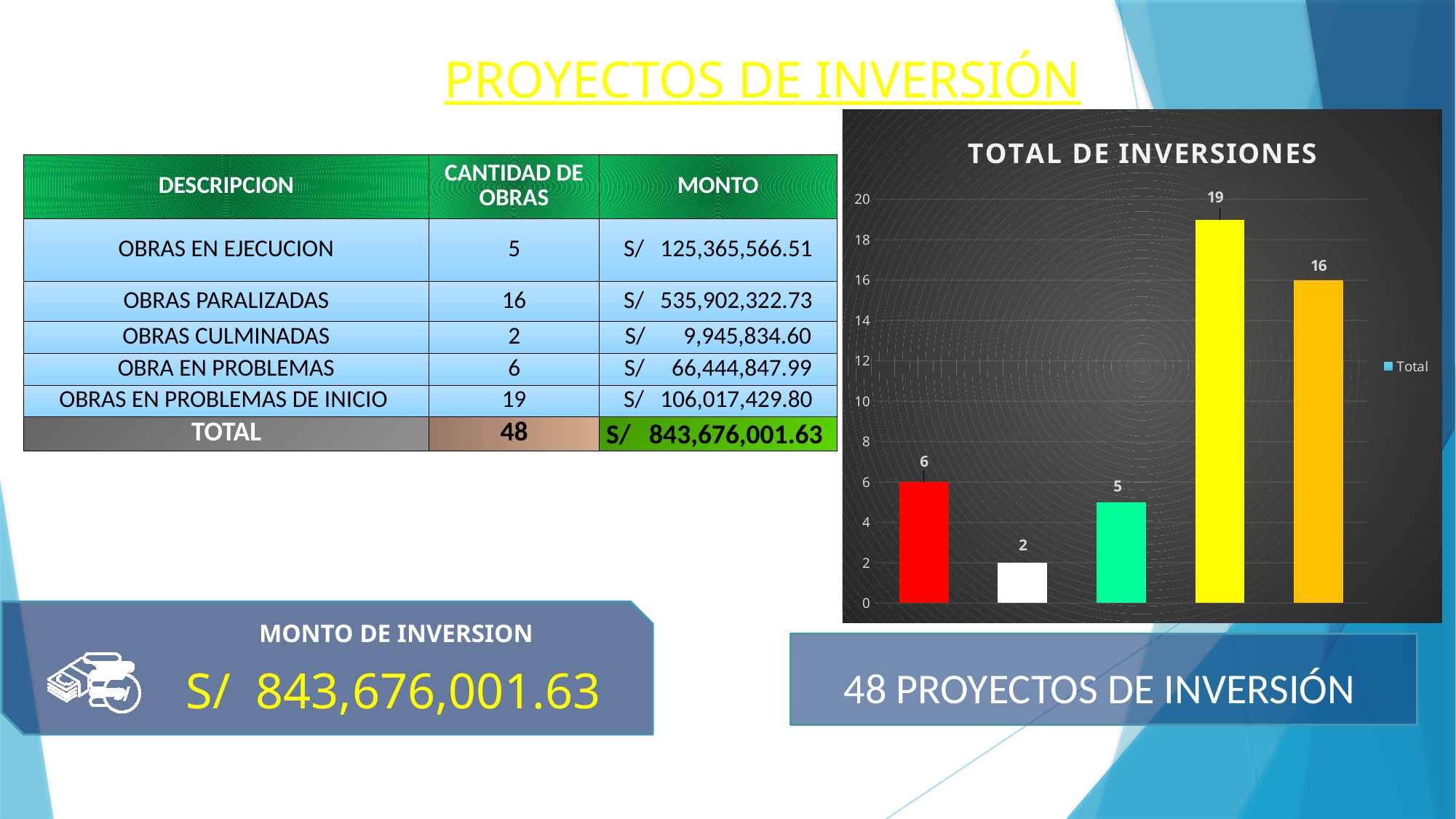
Which is larger in the chart, the red bar or the green bar? the red bar What is the title of the chart on the slide? TOTAL DE INVERSIONES What is the value of the first (red) bar in the chart? 6 How many bars are plotted in the chart? 5 What is the value of the fourth (yellow) bar in the chart? 19 What is the difference between the yellow bar (19) and the orange bar (16) in the chart? 3 What type of chart is shown under the title "TOTAL DE INVERSIONES"? bar chart Which bar in the chart has the lowest value? the second (white) bar, 2 What is the name of the series shown in the chart legend? Total How many series does the chart legend list? 1 Which bar in the chart has the highest value? the fourth (yellow) bar, 19 What is the value of the second (white) bar in the chart? 2